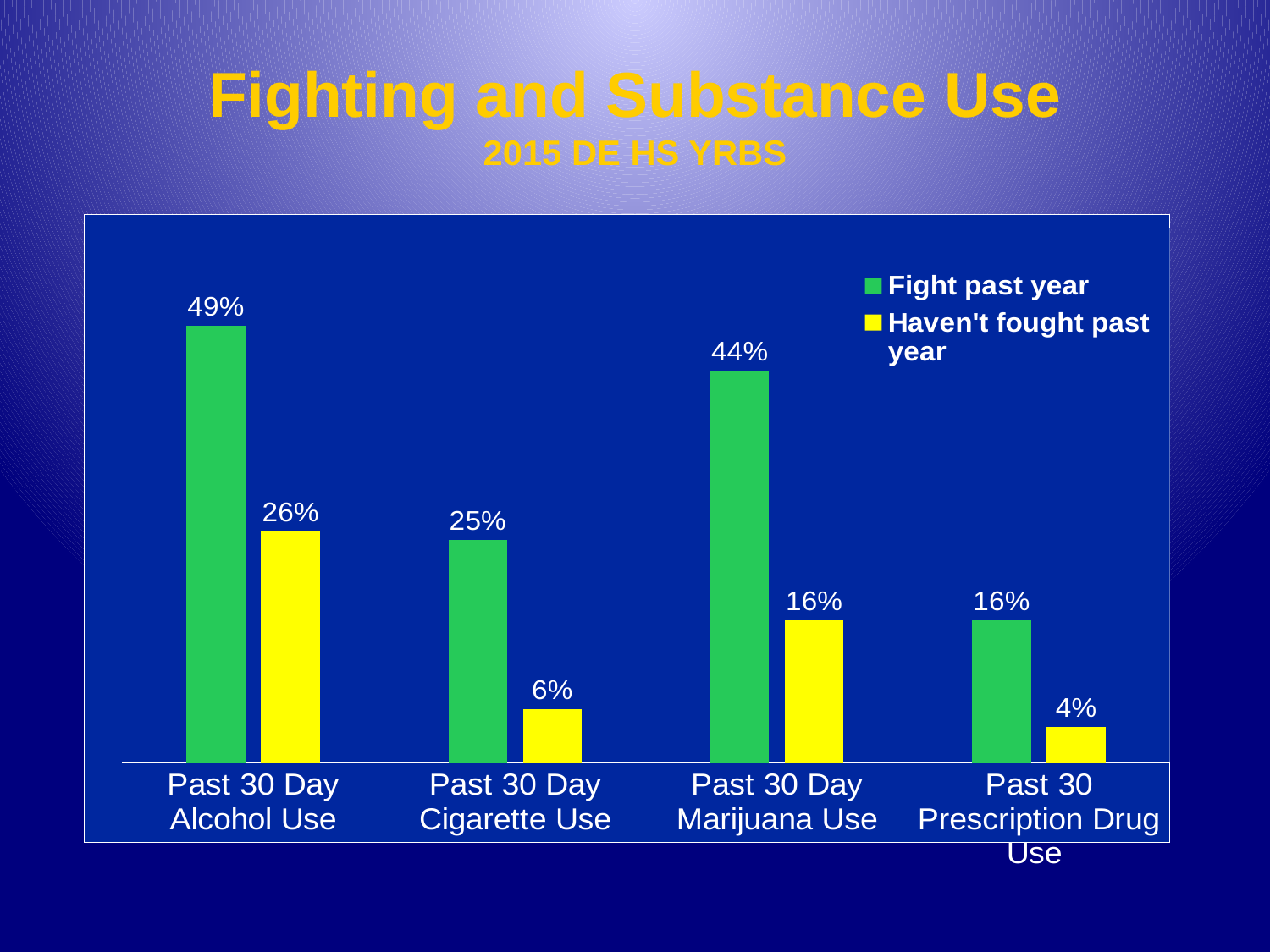
Which is larger for Past 30 Day Cigarette Use: Fight past year or Haven't fought past year? Fight past year How many series does the legend list? 2 What is the value for Haven't fought past year for Past 30 Day Cigarette Use? 6% What kind of chart is shown on the slide? Bar chart What is the difference between Fight past year and Haven't fought past year for Past 30 Day Marijuana Use? 28% Which category has the highest value for Fight past year? Past 30 Day Alcohol Use Which category has the lowest value for Haven't fought past year? Past 30 Prescription Drug Use What is the value for Fight past year for Past 30 Day Alcohol Use? 49% What colour are the bars for the Haven't fought past year series? Yellow What is the value for Haven't fought past year for Past 30 Prescription Drug Use? 4% What is the value for Fight past year for Past 30 Day Marijuana Use? 44% How many categories are shown on the x axis? 4